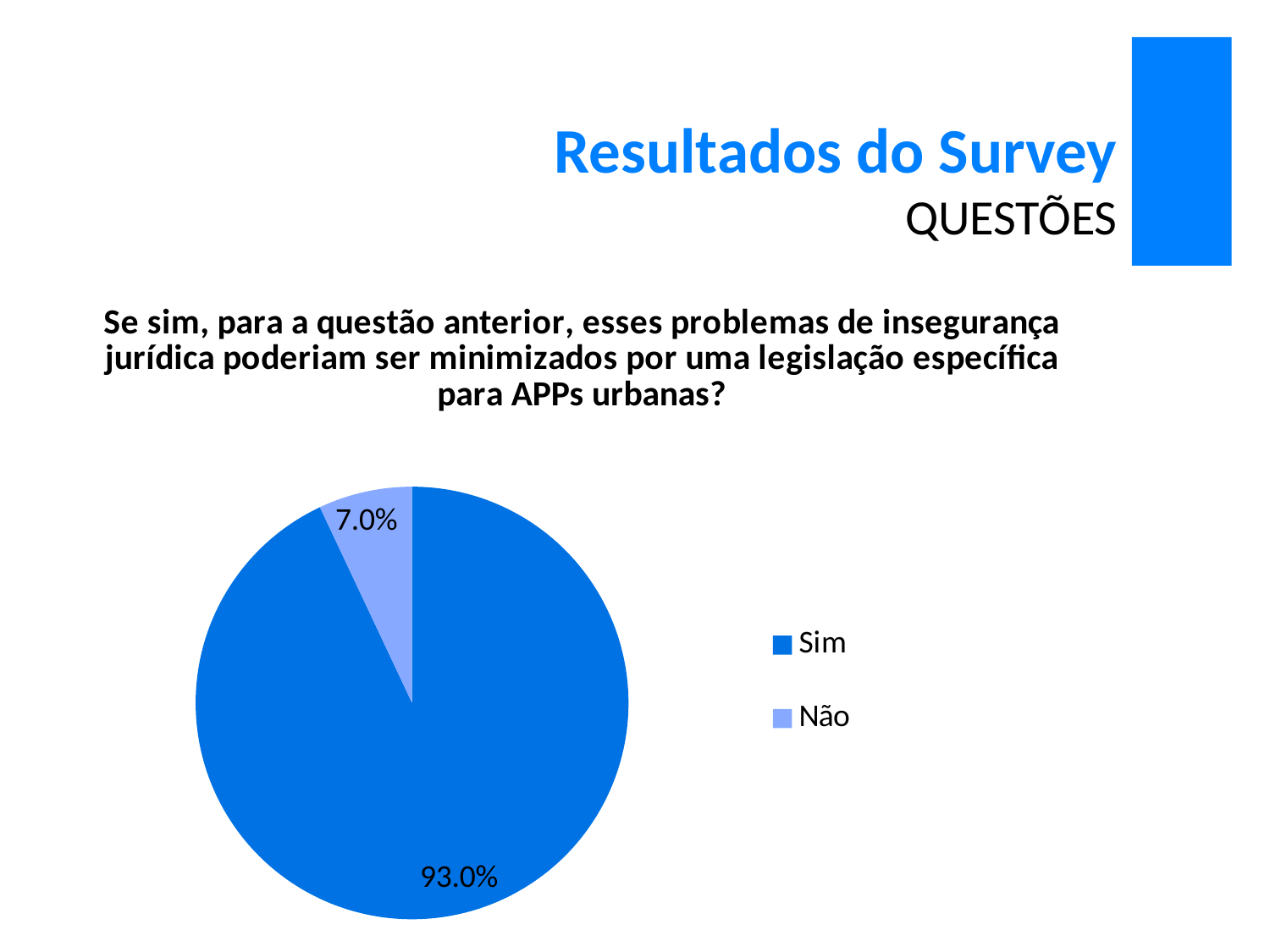
How many slices does the pie chart have? 2 What share of the pie does the "Não" slice represent? 7.0% What kind of chart is shown on the slide? pie chart How many entries does the legend list? 2 What colour is the "Sim" slice in the pie chart? blue Which response has the largest share of the pie? Sim Which response has the smallest share of the pie? Não Which slice is larger, "Sim" or "Não"? Sim What is the difference in percentage points between the "Sim" and "Não" slices? 86.0% Which legend entry is listed first? Sim What percentage of respondents answered "Sim"? 93.0% What percentage of respondents answered "Não"? 7.0%